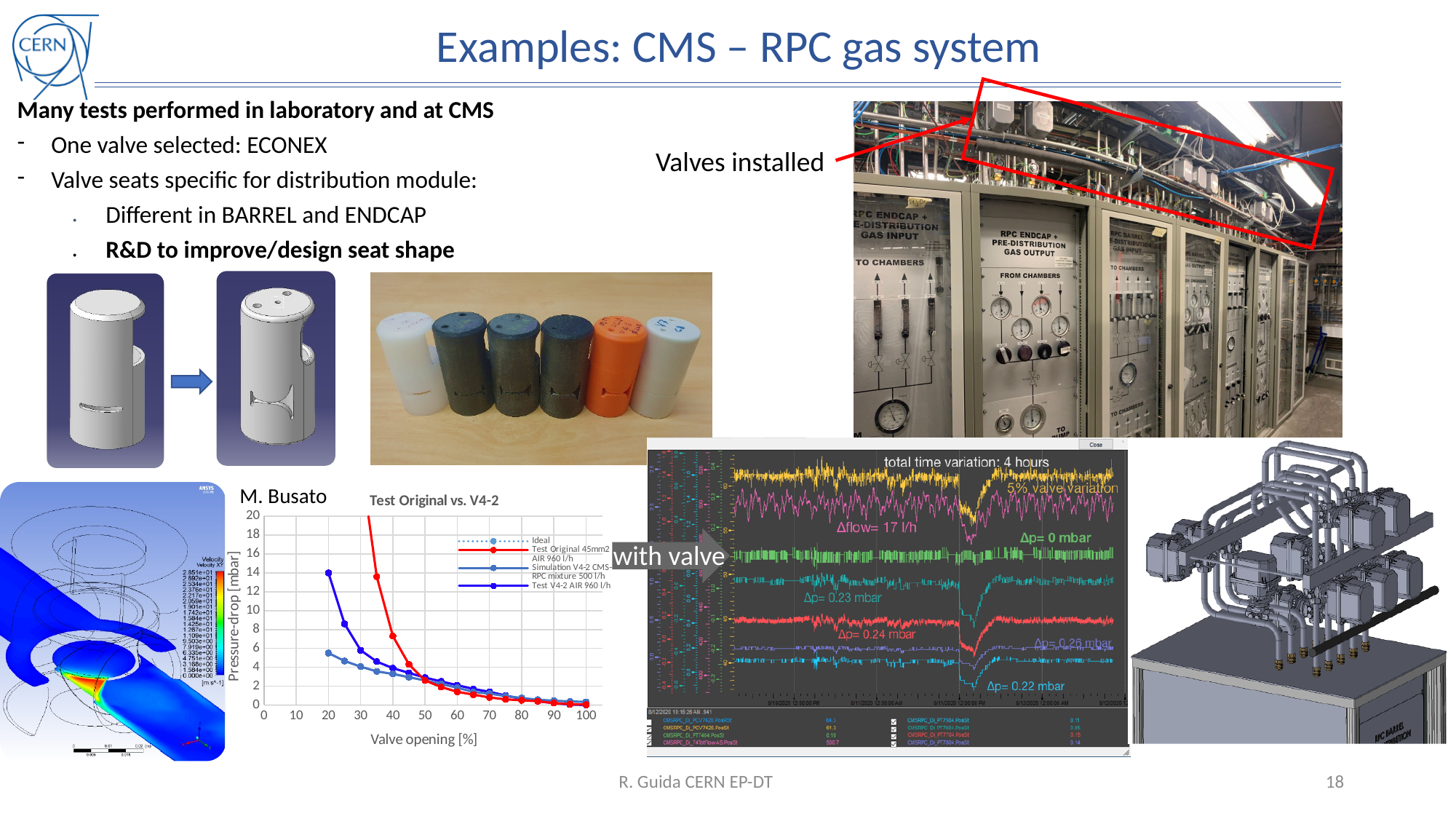
In the 'Test Original vs. V4-2' chart, what is the label of the y axis? Pressure-drop [mbar] In the 'Test Original vs. V4-2' chart, what is the label of the x axis? Valve opening [%] In the 'Test Original vs. V4-2' chart, is the value of the 'Test V4-2 AIR 960 l/h' series at 20% valve opening greater or less than 10? greater In the 'Test Original vs. V4-2' chart, is the value of the 'Simulation V4-2 CMS-RPC mixture 500 l/h' series at 20% valve opening greater or less than 4? greater In the 'Test Original vs. V4-2' chart, is the value of the 'Test V4-2 AIR 960 l/h' series at 30% valve opening greater or less than 8? less In the 'Test Original vs. V4-2' chart, at 35% valve opening, which series has the larger pressure-drop: 'Test Original 45mm2 AIR 960 l/h' or 'Test V4-2 AIR 960 l/h'? Test Original 45mm2 AIR 960 l/h How many series does the legend of the 'Test Original vs. V4-2' chart list? 4 What kind of chart is 'Test Original vs. V4-2'? line chart In the 'Test Original vs. V4-2' chart, does the pressure-drop rise or fall as valve opening increases? fall